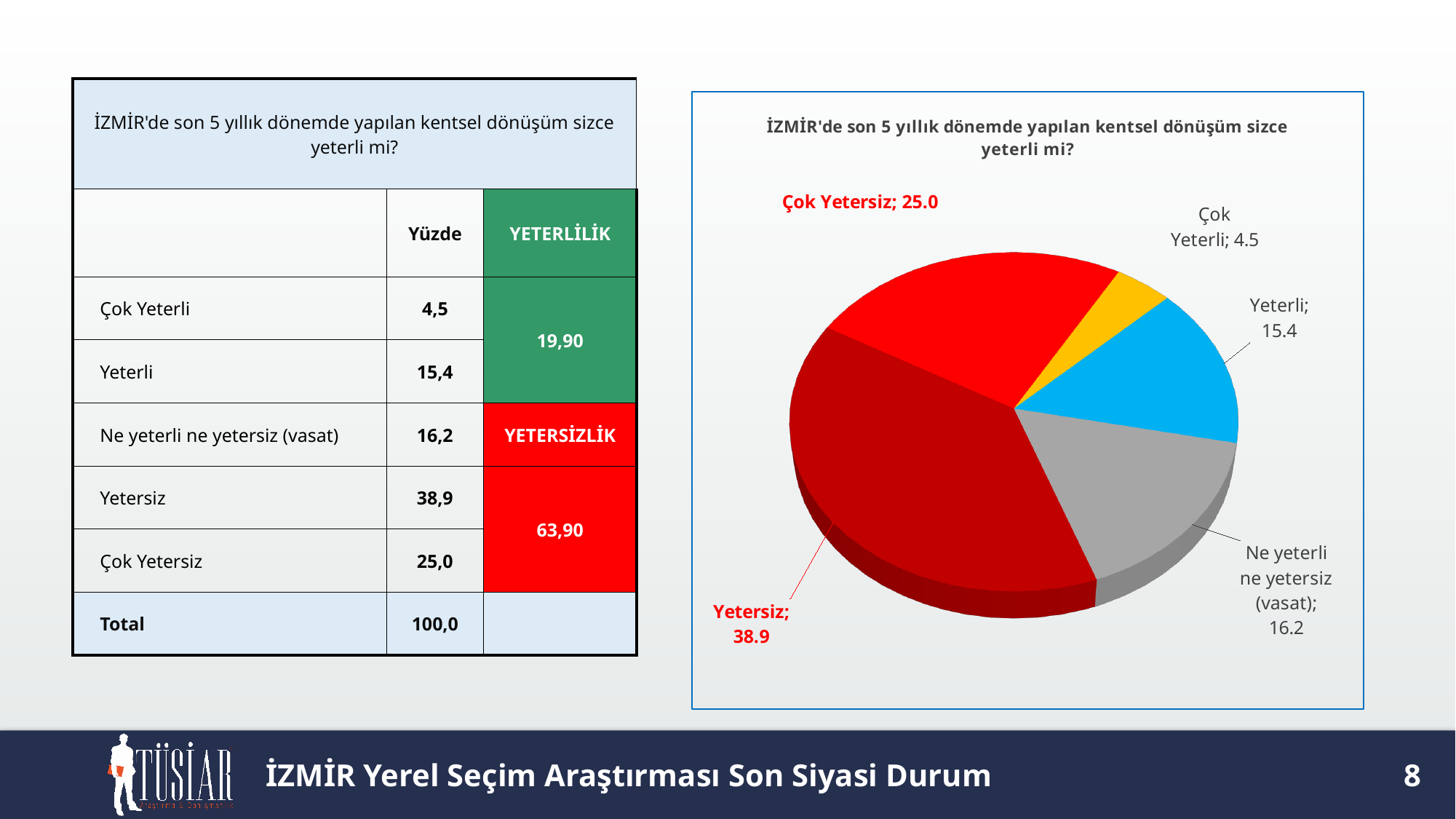
What is the value for Ne yeterli ne yetersiz (vasat) in the pie chart? 16.2 What is the value for Çok Yeterli in the pie chart? 4.5 What is the difference between the values for Yetersiz and Çok Yetersiz in the pie chart? 13.9 Which is larger in the pie chart, Yeterli or Ne yeterli ne yetersiz (vasat)? Ne yeterli ne yetersiz (vasat) What is the combined value of Yetersiz and Çok Yetersiz in the pie chart? 63.9 What is the value for Çok Yetersiz in the pie chart? 25.0 What is the value for Yetersiz in the pie chart? 38.9 Which category has the largest slice in the pie chart? Yetersiz What colour is the Yeterli slice in the pie chart? blue What kind of chart is shown on the slide? pie chart How many slices does the pie chart have? 5 Which category has the smallest slice in the pie chart? Çok Yeterli